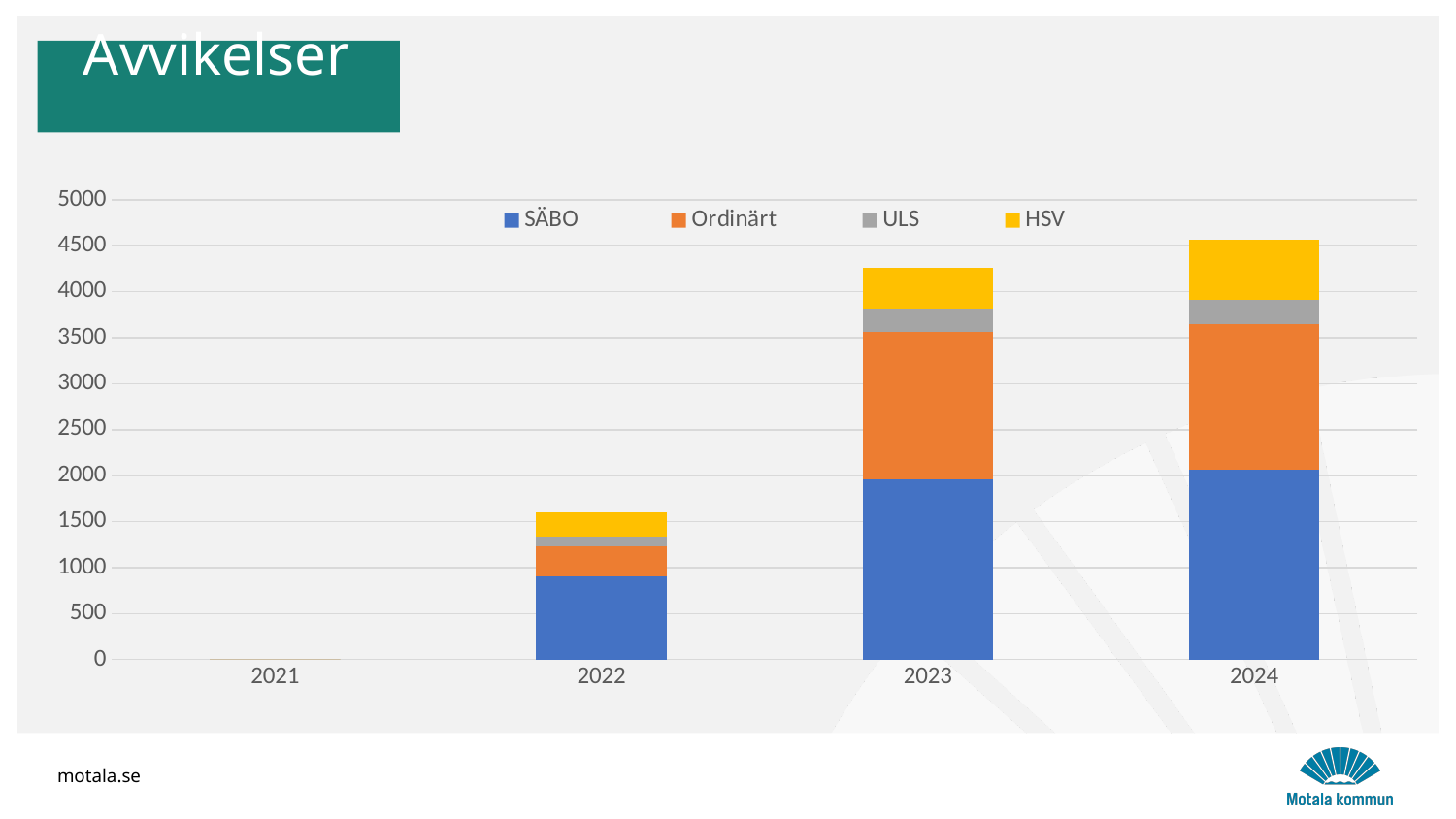
How many years are shown on the x axis? 4 What kind of chart is shown on the slide? Stacked bar chart Is the SÄBO value for 2024 greater or less than 1500? greater Is the total stacked value for 2023 greater or less than 4000? greater Which year has the larger total, 2022 or 2023? 2023 How many series does the legend list? 4 Is the total stacked value for 2022 greater or less than 2000? less Do the total values rise or fall from 2021 to 2024? Rise What are the series names listed in the legend? SÄBO, Ordinärt, ULS, HSV Which year has the tallest stacked bar? 2024 What colour represents HSV in the chart? Yellow Which year has the lowest total? 2021